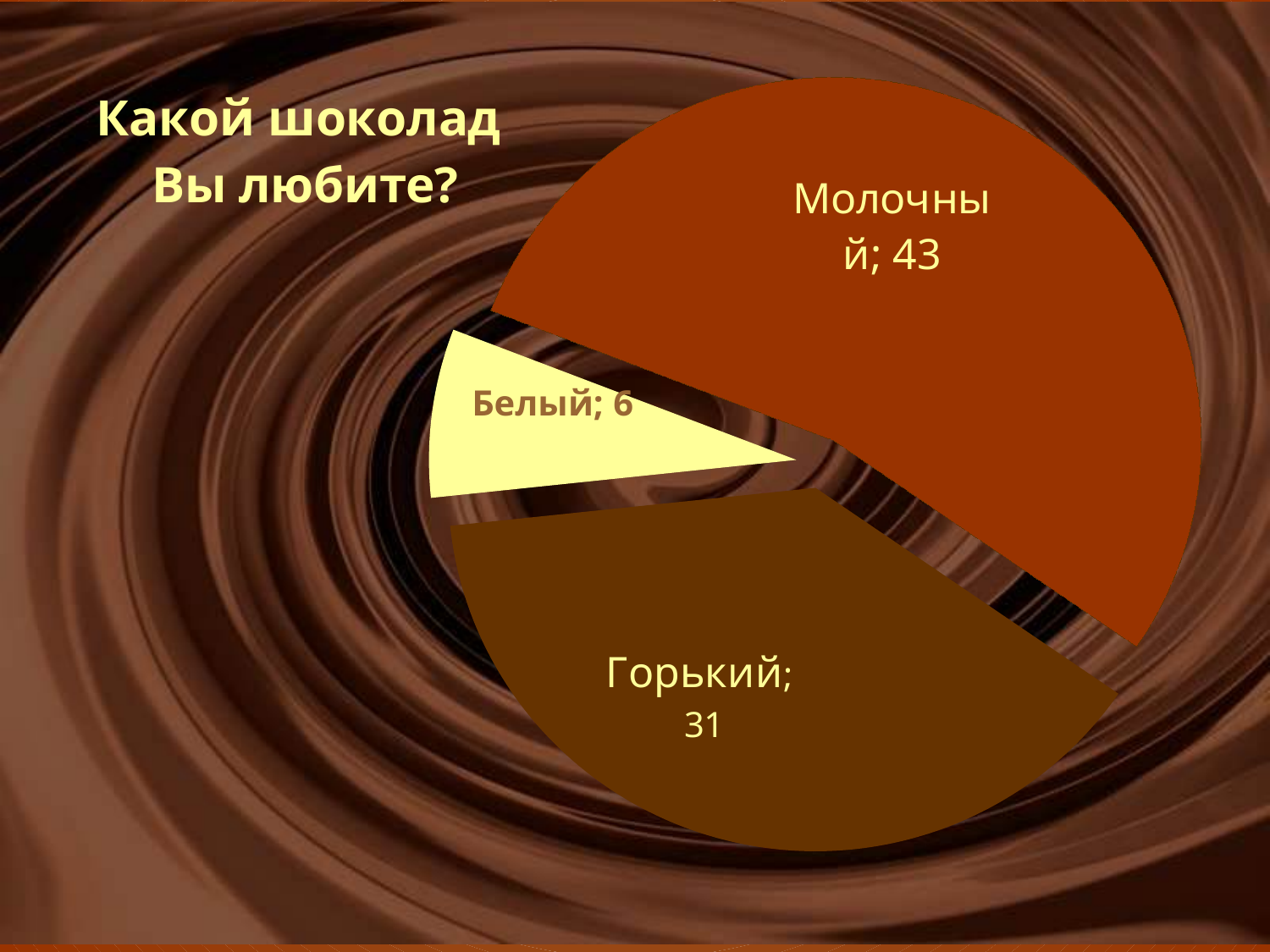
What question is written as the heading above the chart? Какой шоколад Вы любите? What kind of chart is shown on the slide? pie chart What is the value for Белый? 6 Which category has the smallest slice? Белый Which category has the largest slice? Молочный What is the total of all slices in the pie chart? 80 What is the difference between the values for Молочный and Горький? 12 What is the difference between the values for Горький and Белый? 25 Which is larger, the value for Горький or the value for Белый? Горький How many slices does the pie chart have? 3 What is the value for Горький? 31 What is the value for Молочный? 43